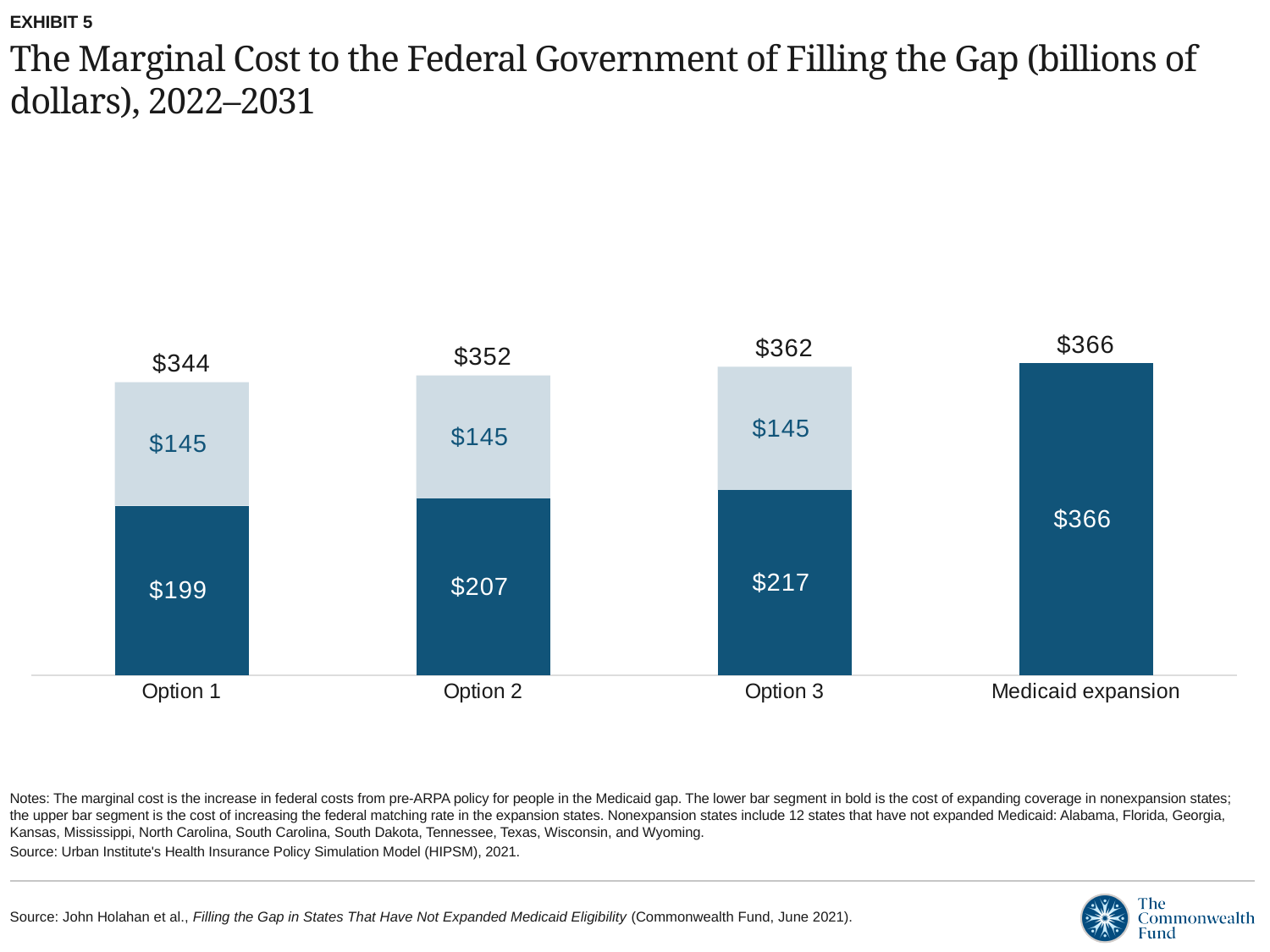
What is the difference between the lower bar segment for Option 2 and the lower bar segment for Option 1? $8 What kind of chart is shown on the slide? Stacked bar chart Which is larger: the lower bar segment for Option 3 or the lower bar segment for Option 2? Option 3 Do the total values rise or fall moving from Option 1 to Medicaid expansion along the x axis? Rise What is the total marginal cost shown for Option 1? $344 Which category has the lowest total marginal cost? Option 1 What is the difference between the total for Medicaid expansion and the total for Option 1? $22 What is the total of the stacked bar for Option 3? $362 Which category has the highest total marginal cost? Medicaid expansion How many categories are shown on the x axis? 4 What is the value of the upper (light) bar segment for Option 2? $145 What is the value of the lower (dark) bar segment for Option 3? $217